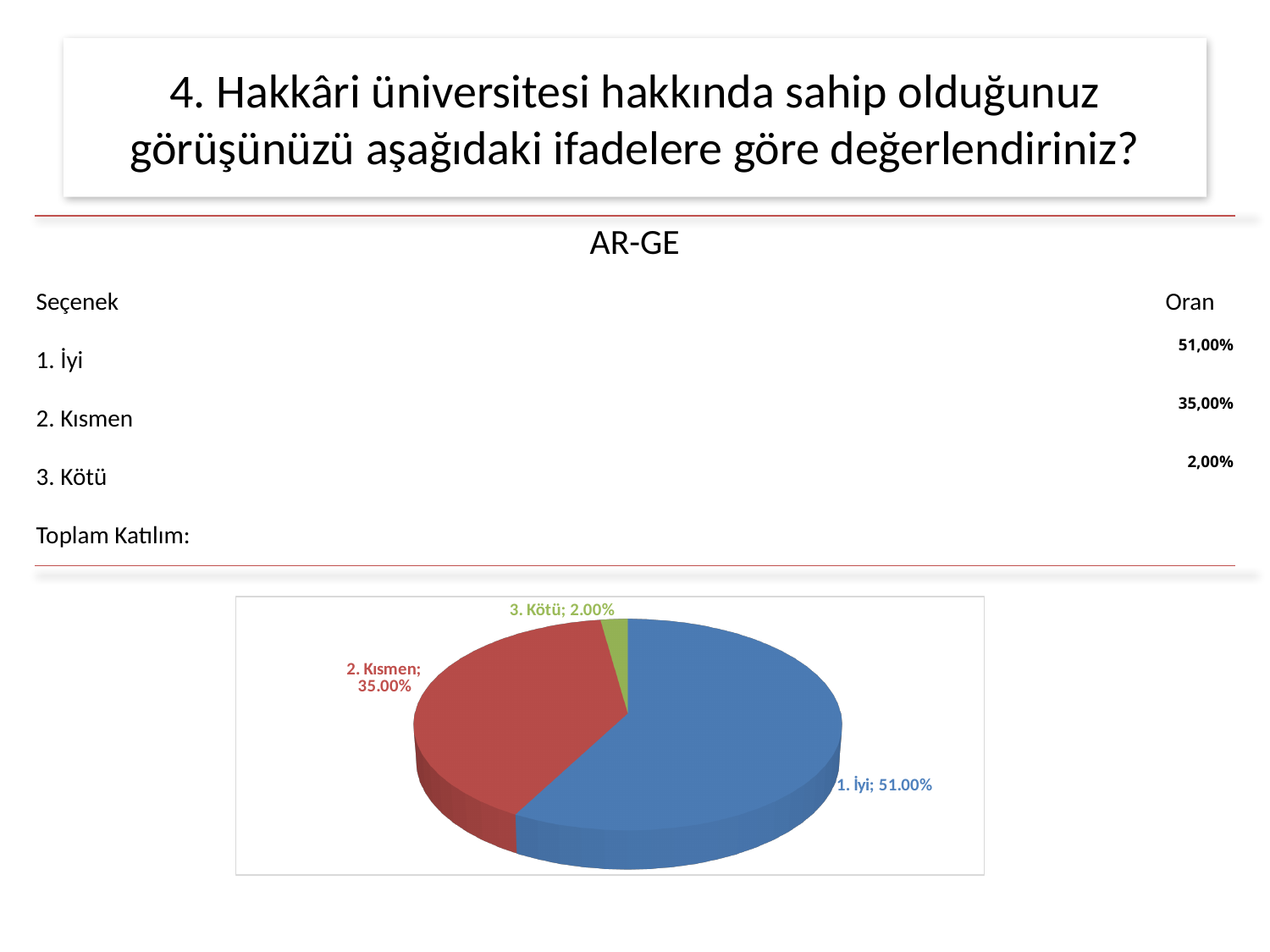
What is the value shown for the slice labelled "2. Kısmen" in the pie chart? 35.00% What is the difference between the values for "1. İyi" and "2. Kısmen" in the pie chart? 16.00% How many slices does the pie chart have? 3 What is the value shown for the slice labelled "1. İyi" in the pie chart? 51.00% Which slice of the pie chart is the largest? 1. İyi Which slice of the pie chart is the smallest? 3. Kötü What colour is the slice for "3. Kötü" in the pie chart? green What is the value shown for the slice labelled "3. Kötü" in the pie chart? 2.00% What is the difference between the values for "2. Kısmen" and "3. Kötü" in the pie chart? 33.00% What kind of chart is shown on the slide? pie chart What colour is the slice for "1. İyi" in the pie chart? blue Which is larger in the pie chart, the value for "2. Kısmen" or the value for "3. Kötü"? 2. Kısmen